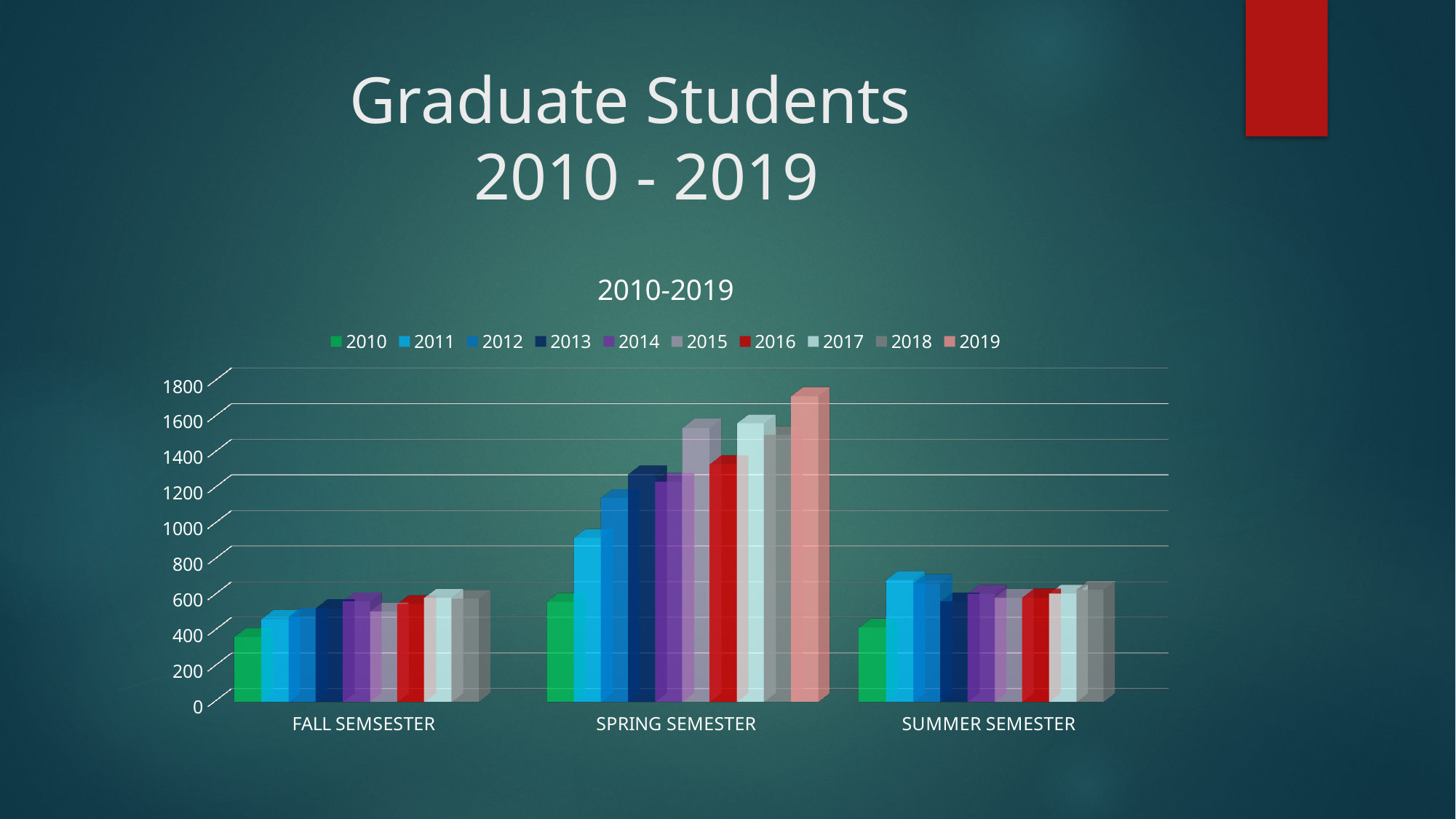
Is the value for 2010 in the Spring Semester greater or less than 800? less Is the value for 2019 in the Spring Semester greater or less than 1600? greater What kind of chart is shown on the slide? bar chart Which year has the highest value for the Spring Semester? 2019 Is the value for 2010 in the Summer Semester greater or less than 600? less Which year has the lowest value for the Fall Semester? 2010 How many series does the chart's legend list? 10 Which semester has the tallest bars overall in the chart? Spring Semester Which year has the lowest value for the Spring Semester? 2010 What is the title of the chart? 2010-2019 How many semester categories are shown on the x axis of the chart? 3